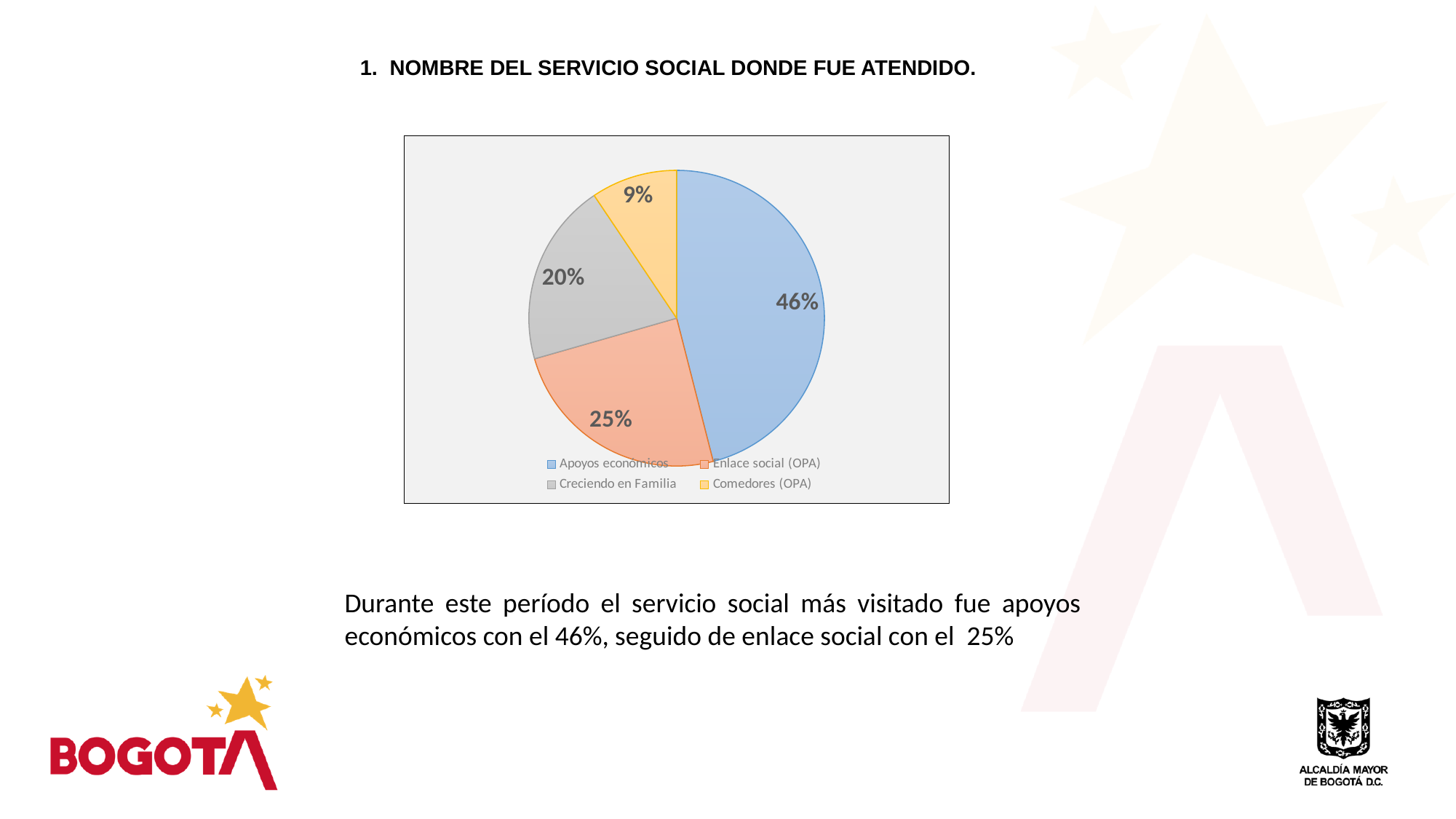
Which category has the smallest slice of the pie? Comedores (OPA) What share of the pie does Apoyos económicos have? 46% What colour is the slice for Enlace social (OPA)? orange What share of the pie does Enlace social (OPA) have? 25% Which category has the largest slice of the pie? Apoyos económicos What kind of chart is shown on the slide? pie chart What share of the pie does Creciendo en Familia have? 20% How many slices does the pie chart have? 4 How many entries does the legend list? 4 What is the difference in percentage points between Apoyos económicos and Enlace social (OPA)? 21 Which is larger, the slice for Creciendo en Familia or the slice for Comedores (OPA)? Creciendo en Familia